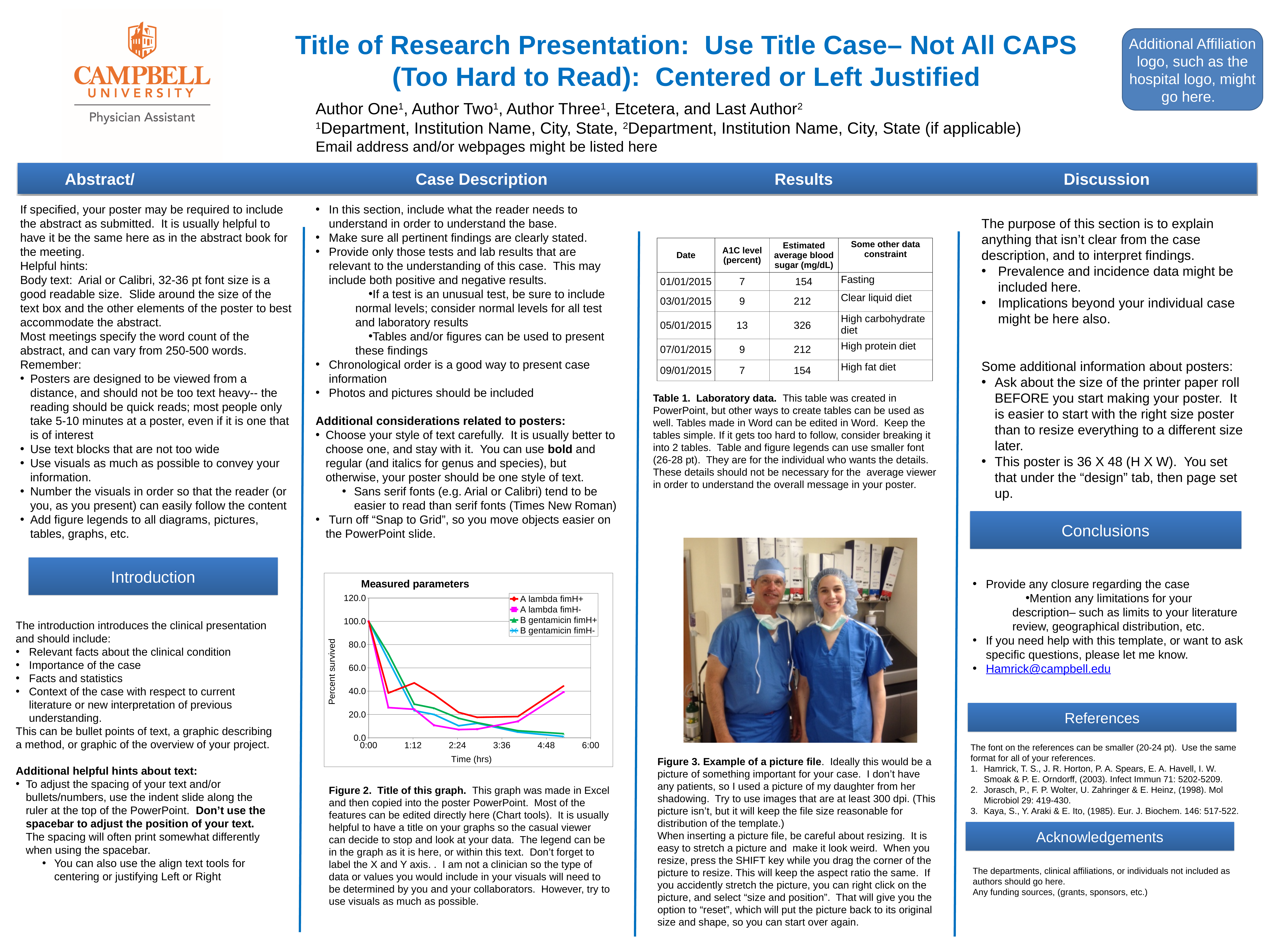
How many series does the chart legend list? 4 Is the value for A lambda fimH- at 1:12 greater or less than 40.0? less What is the value for A lambda fimH+ at time 0:00? 100.0 What kind of chart is shown on the slide? line chart At time 4:48, which is larger: A lambda fimH+ or B gentamicin fimH+? A lambda fimH+ What is the label of the y axis of the chart? Percent survived What is the title of the chart? Measured parameters Is the value for B gentamicin fimH+ at 4:48 greater or less than 20.0? less Is the value for A lambda fimH+ at 1:12 greater or less than 20.0? greater Do the values for B gentamicin fimH- generally rise or fall along the x axis? fall What is the value for B gentamicin fimH- at time 0:00? 100.0 Which series has the highest value at time 1:12? A lambda fimH+